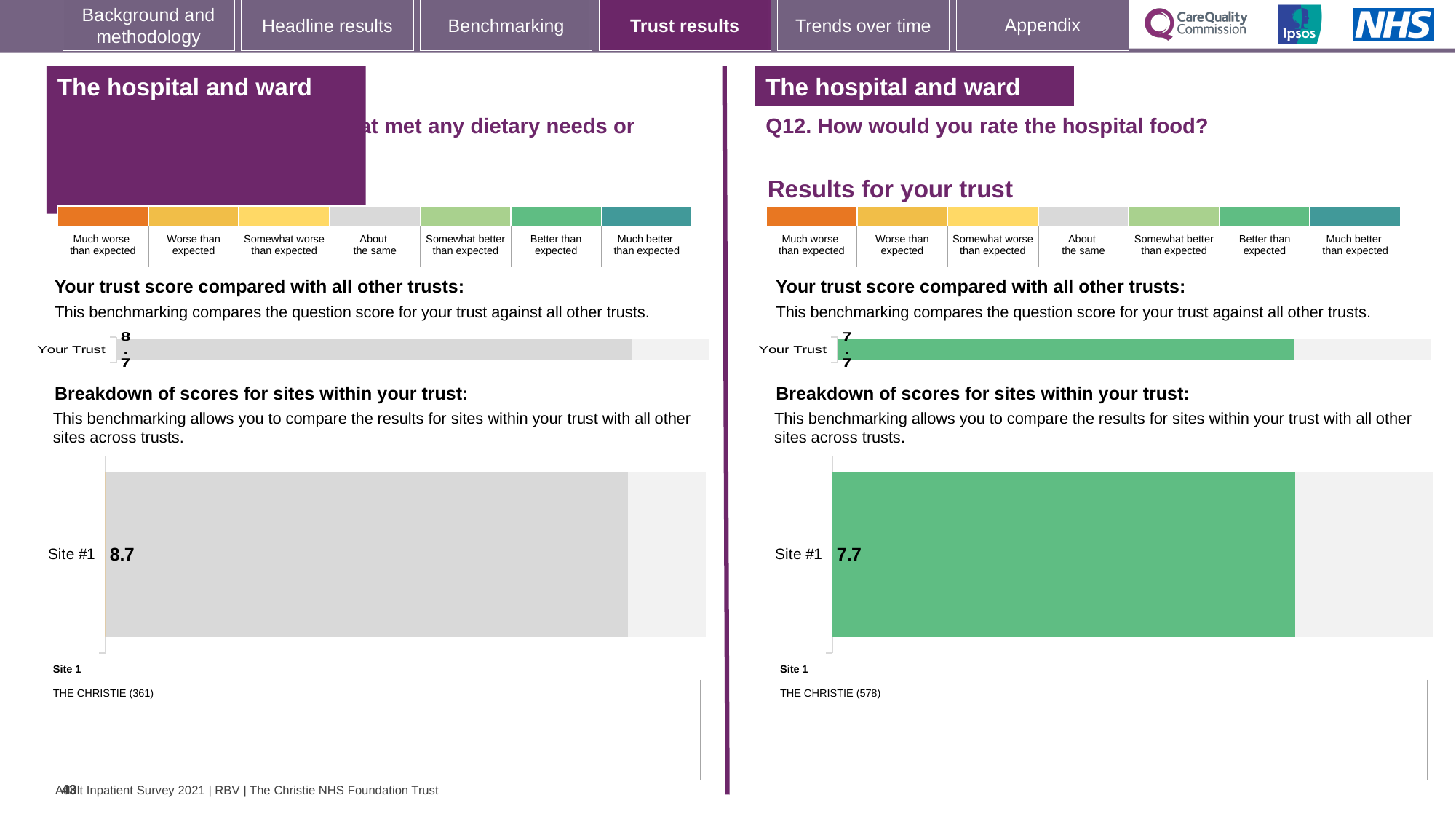
On the right-hand chart for Q12, what colour is the Site #1 bar? Green What kind of chart is used to show the Site #1 score on the right-hand side for Q12? Bar chart On the right-hand chart for Q12 (hospital food), what is the score shown for Your Trust? 7.7 On the right-hand chart for Q12 (hospital food), what is the score shown for Site #1? 7.7 According to the colour key, which benchmark category does the grey Site #1 bar on the left-hand chart correspond to? About the same On the left-hand chart (dietary needs question), what is the score shown for Your Trust? 8.7 Which Site #1 score is larger: the one on the left-hand chart or the one on the right-hand chart for Q12? The left-hand chart (8.7) What is the difference between the Site #1 score on the left-hand chart and the Site #1 score on the right-hand chart for Q12? 1.0 On the left-hand chart (dietary needs question), what is the score shown for Site #1? 8.7 How many benchmark categories are listed in the colour key above the right-hand chart for Q12? 7 How many sites are shown in the breakdown of scores on the right-hand chart for Q12? 1 On the right-hand chart for Q12, what is the name and respondent count given for Site 1? THE CHRISTIE (578)